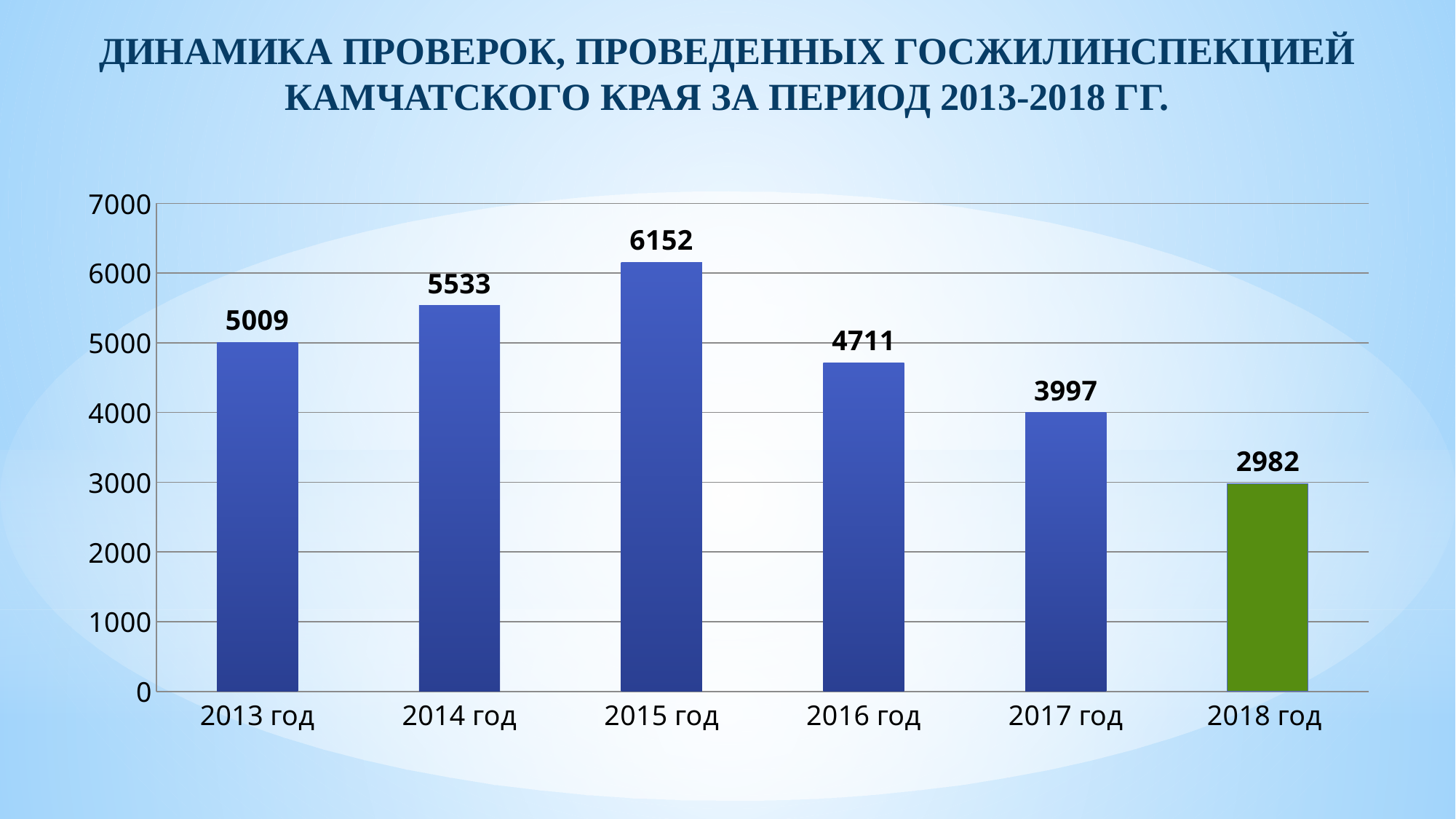
Is the value for 2017 год greater or less than 4000? less What is the difference between the values for 2015 год and 2018 год? 3170 What is the value for 2015 год? 6152 What is the value for 2018 год? 2982 Which year has the lowest value? 2018 год What kind of chart is shown on the slide? bar chart Which is larger, the value for 2016 год or the value for 2017 год? 2016 год Do the values rise or fall from 2015 год to 2018 год? fall Which year has the highest value? 2015 год What is the value for 2013 год? 5009 What is the difference between the values for 2013 год and 2014 год? 524 How many years are shown on the chart? 6